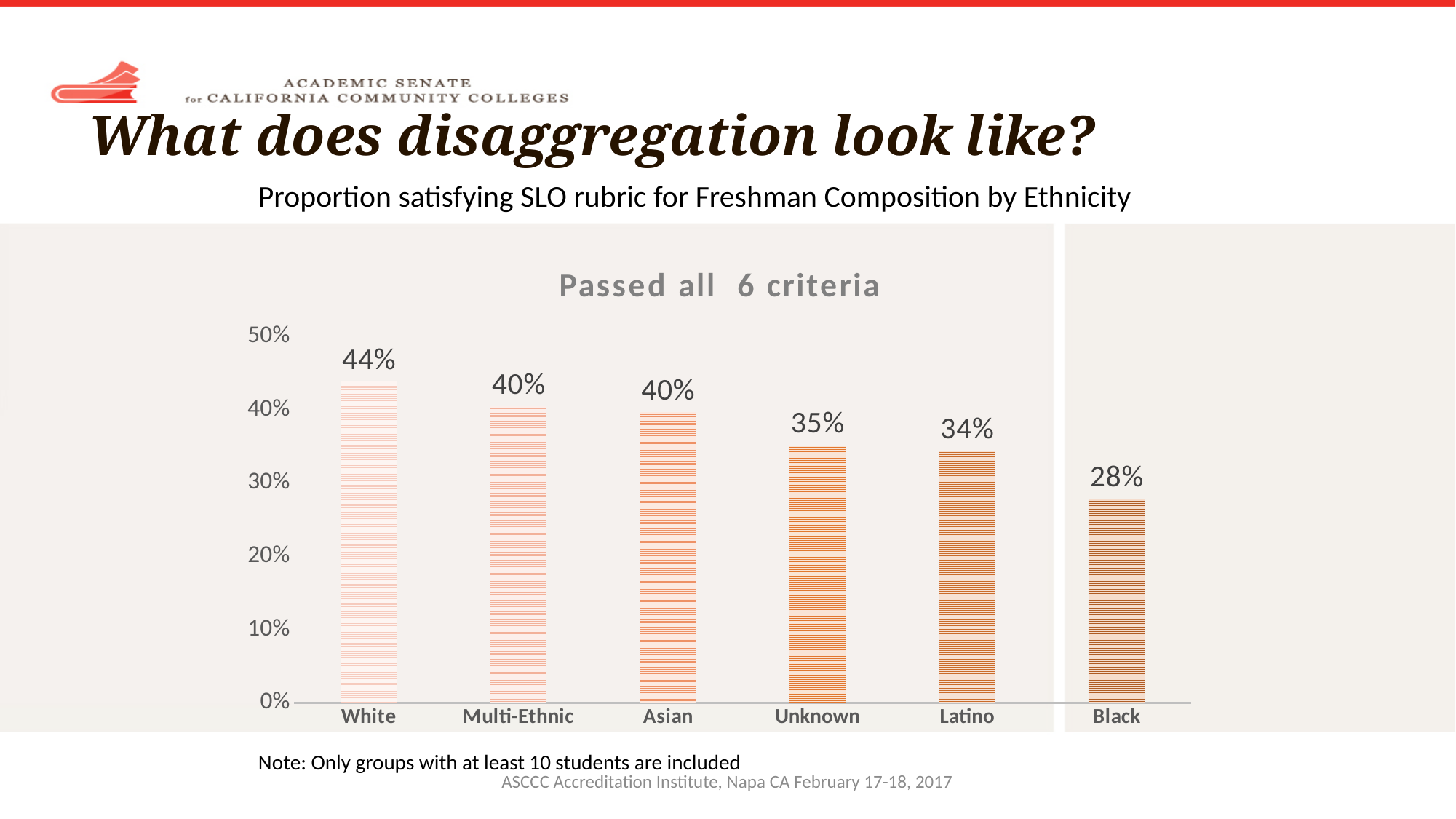
What is the title of the chart? Passed all 6 criteria Which category has the highest value? White What is the difference between the values for White and Black? 16% What is the value for Unknown? 35% What is the value for Latino? 34% Which category has the lowest value? Black What kind of chart is this? Bar chart What is the value for Black? 28% Which is larger, the value for Unknown or the value for Black? Unknown Do the values rise or fall from left to right along the x axis? Fall How many categories are shown on the x axis? 6 What is the value for White? 44%